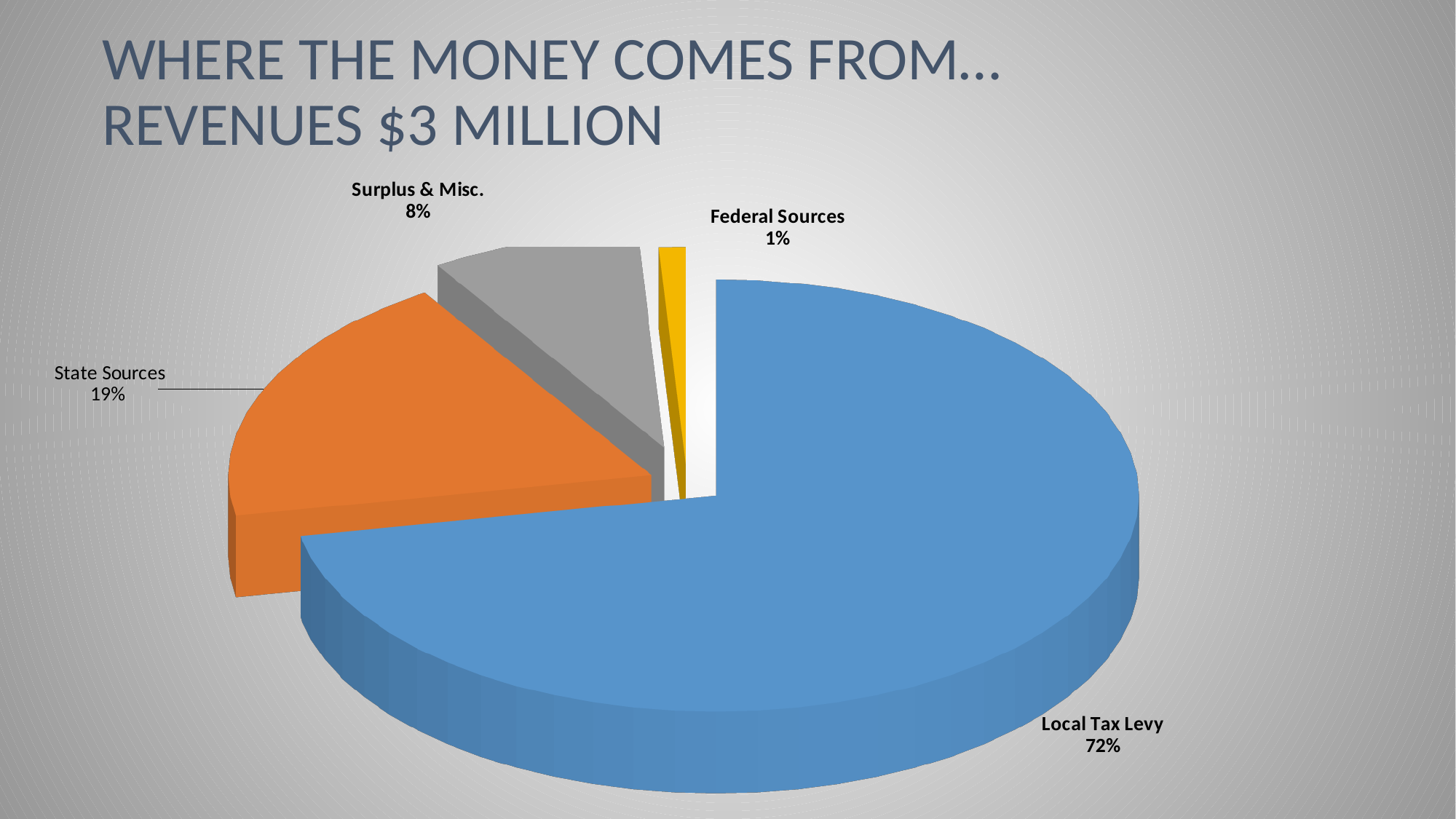
Which is larger, the share for Surplus & Misc. or the share for Federal Sources? Surplus & Misc. What share of revenues comes from Federal Sources? 1% Which revenue source has the smallest share of the pie? Federal Sources What colour is the Local Tax Levy slice? Blue Which revenue source has the largest share of the pie? Local Tax Levy How many slices does the pie chart have? 4 What is the difference in percentage points between State Sources and Surplus & Misc.? 11 What share of revenues comes from State Sources? 19% What kind of chart is shown on the slide? Pie chart What is the difference in percentage points between Local Tax Levy and State Sources? 53 What share of revenues comes from Surplus & Misc.? 8%